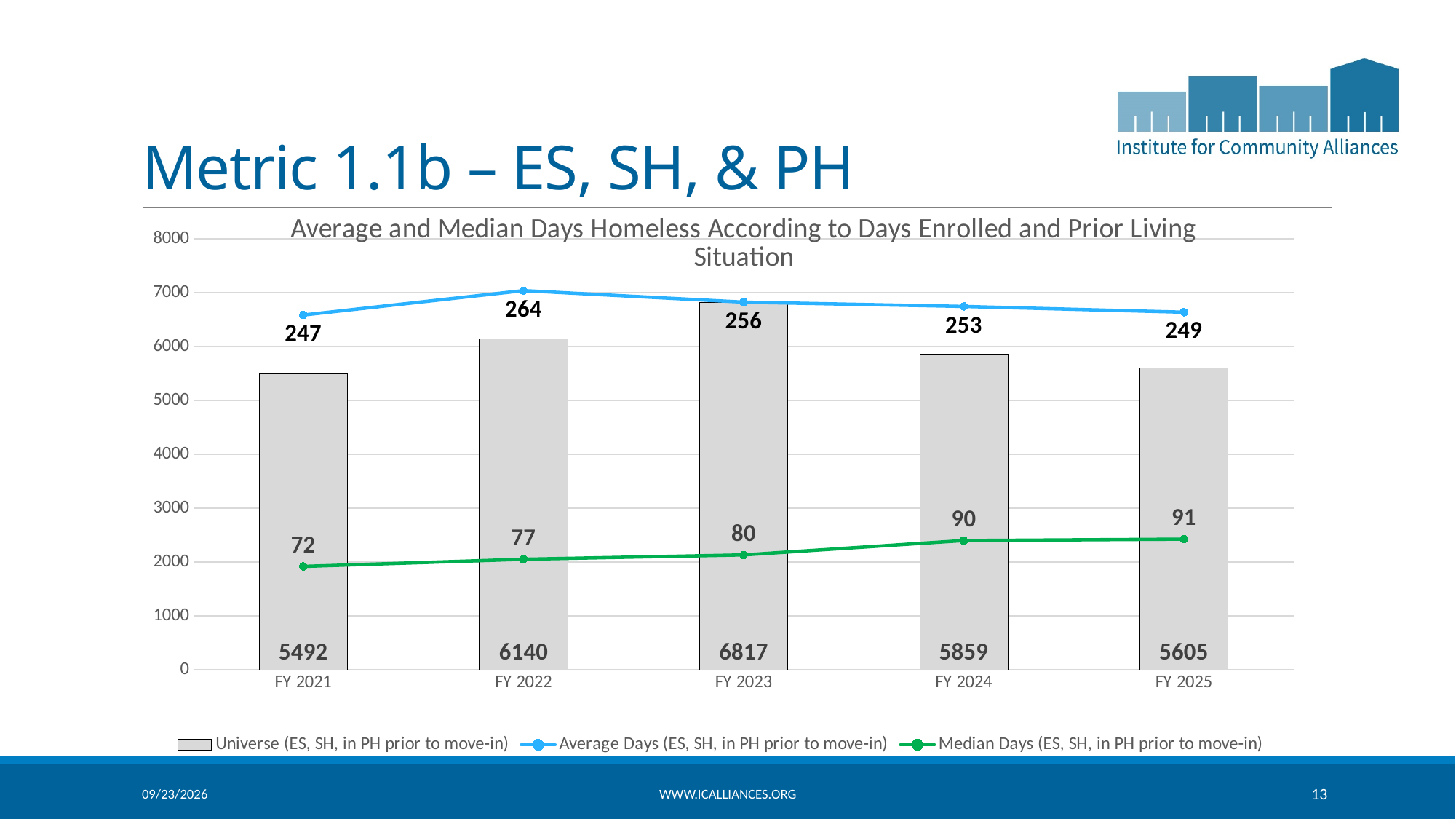
What is the difference between the Universe values for FY 2022 and FY 2021? 648 What is the Universe value for FY 2023? 6817 Which fiscal year has the lowest Median Days value? FY 2021 Which is larger, the Average Days value for FY 2024 or for FY 2025? FY 2024 How many series does the legend list? 3 Which fiscal year has the highest Universe value? FY 2023 How many fiscal years are shown on the x axis? 5 Does the Median Days series rise or fall from FY 2021 to FY 2025? rise Is the Universe bar for FY 2024 greater or less than 6000? less What is the title of the chart? Average and Median Days Homeless According to Days Enrolled and Prior Living Situation What is the Average Days value for FY 2022? 264 What is the Median Days value for FY 2025? 91